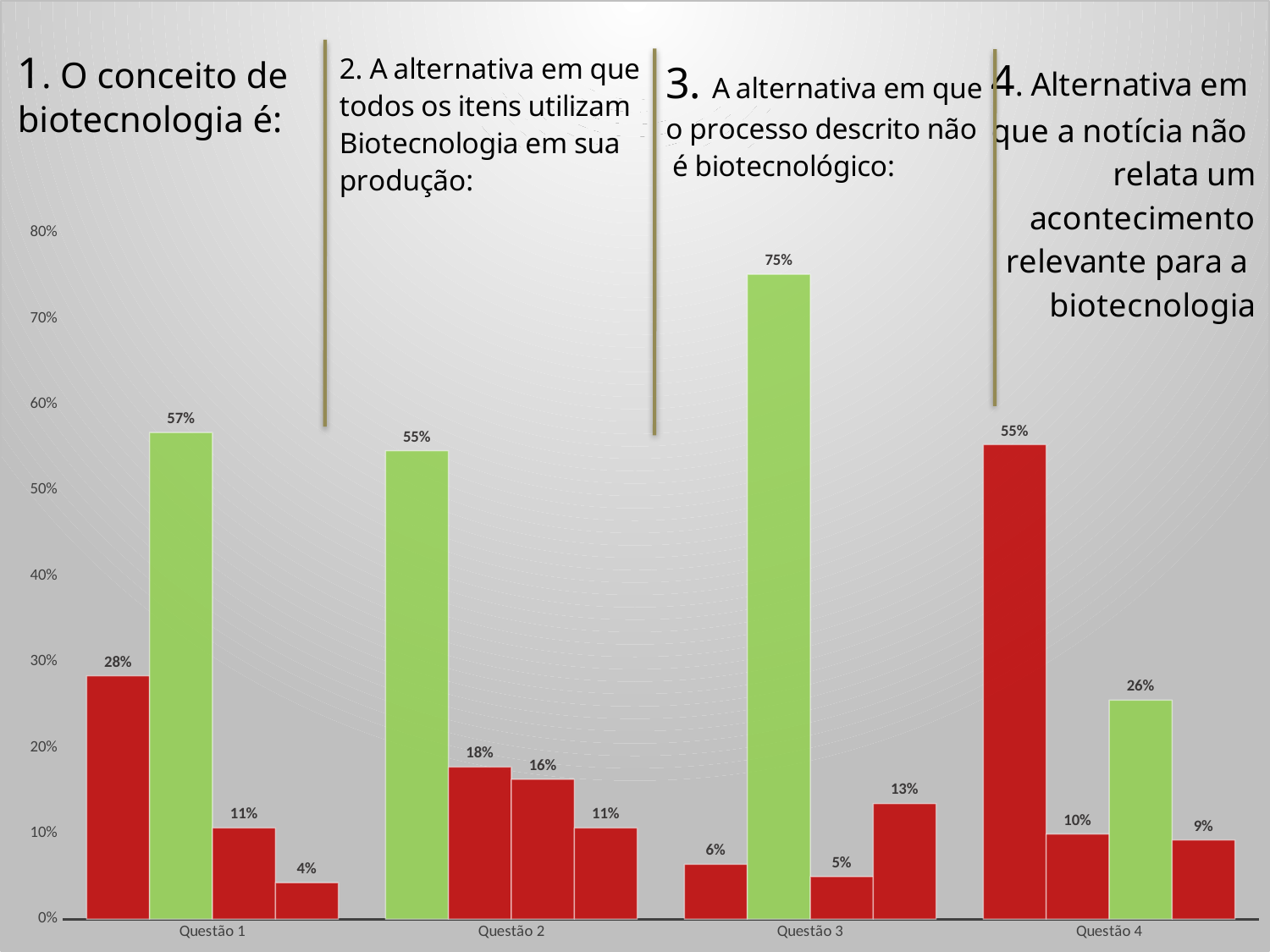
What kind of chart is shown on the slide? bar chart What is the value of the green bar for Questão 1? 57% What is the difference between the green bar for Questão 3 (75%) and the green bar for Questão 1 (57%)? 18% What is the value of the green bar for Questão 3? 75% What is the value of the green bar for Questão 4? 26% Is the value of the green bar for Questão 3 greater or less than 70%? greater How many categories are shown on the x axis of the chart? 4 Which category contains the highest bar in the chart? Questão 3 Which is larger: the green bar for Questão 2 or the green bar for Questão 4? the green bar for Questão 2 How many bars are plotted for each Questão category? 4 What is the value of the tallest red bar for Questão 4? 55% What is the smallest value labelled for Questão 1? 4%